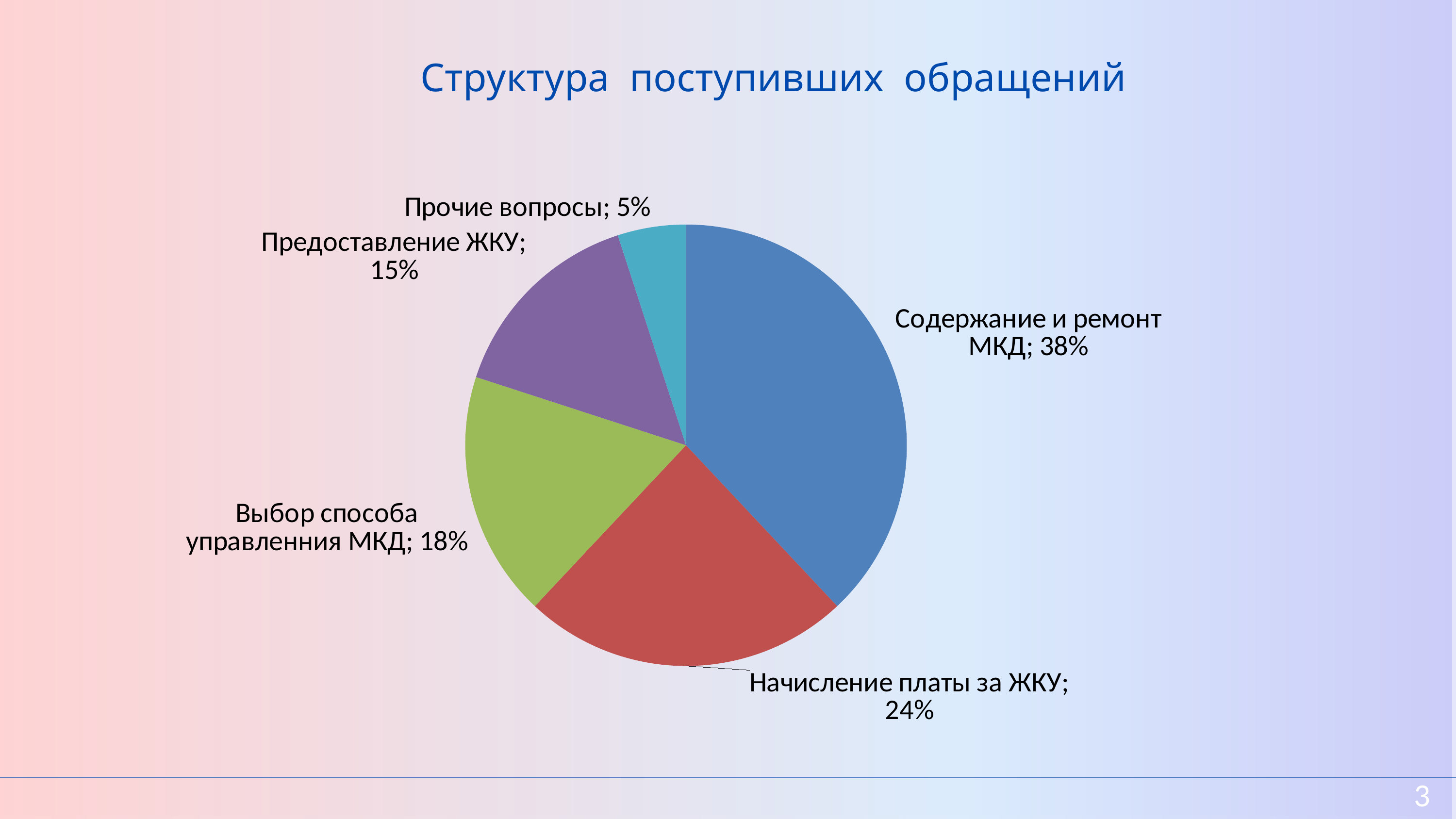
What is the value for "Начисление платы за ЖКУ"? 24% How many categories are shown in the pie chart? 5 What is the value for "Выбор способа управлення МКД"? 18% What is the title of the chart? Структура поступивших обращений What is the difference between the shares of "Содержание и ремонт МКД" and "Начисление платы за ЖКУ"? 14% Which category has the smallest share of the pie? Прочие вопросы What is the value for "Предоставление ЖКУ"? 15% What type of chart is shown on the slide? Pie chart Which is larger: the share for "Выбор способа управлення МКД" or for "Предоставление ЖКУ"? Выбор способа управлення МКД What is the value for "Прочие вопросы"? 5% Which category has the largest share of the pie? Содержание и ремонт МКД What share of the pie does "Содержание и ремонт МКД" have? 38%